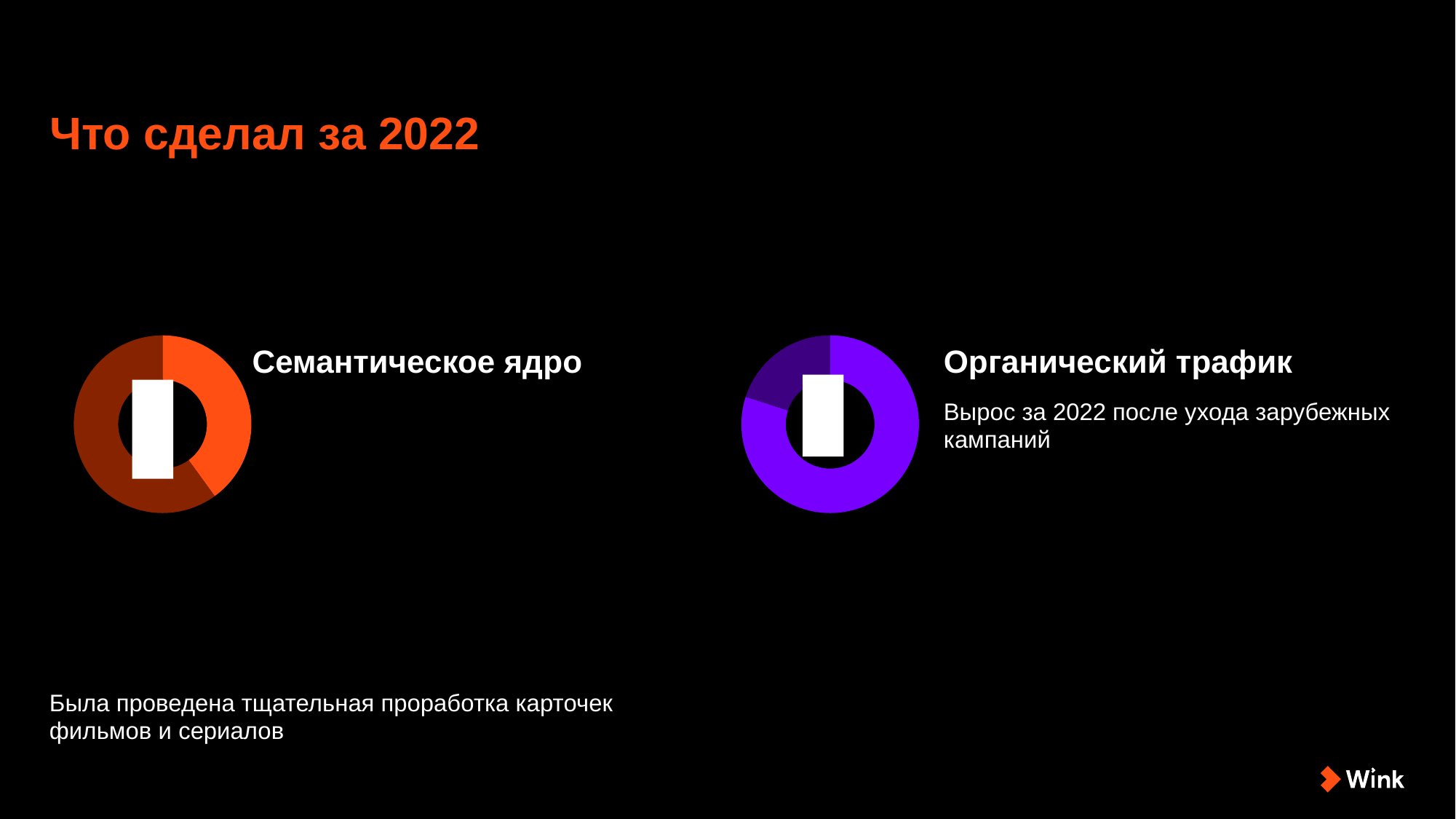
What colour is the donut chart on the right side of the slide? Purple How many donut charts are shown on the slide? 2 In the chart titled "Семантическое ядро", how many slices does the donut have? 2 In the chart titled "Органический трафик", is the dark purple slice greater or less than half of the donut? less What is the title of the chart on the left side of the slide? Семантическое ядро What kind of chart is the chart titled "Семантическое ядро"? Pie chart (donut) In the chart titled "Органический трафик", how many slices does the donut have? 2 What kind of chart is the chart titled "Органический трафик"? Pie chart (donut) In the chart titled "Органический трафик", which slice is larger, the bright purple one or the dark purple one? The bright purple one